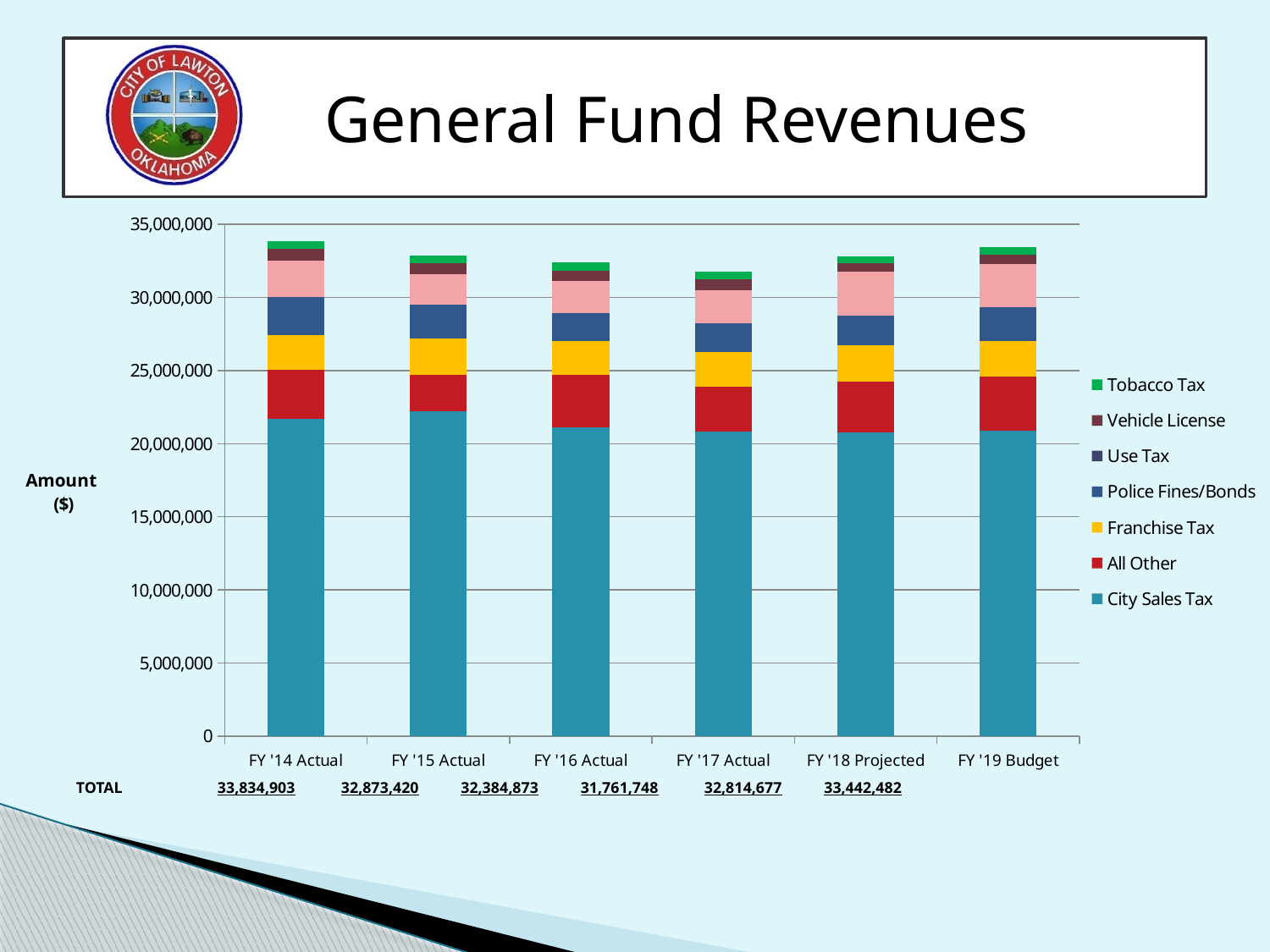
Is the City Sales Tax value for FY '15 Actual greater or less than 20,000,000? greater Which fiscal year has the lowest TOTAL general fund revenue? FY '17 Actual What is the TOTAL shown for FY '14 Actual? 33,834,903 What is the TOTAL shown for FY '19 Budget? 33,442,482 What is the TOTAL shown for FY '17 Actual? 31,761,748 Which TOTAL is larger, FY '15 Actual or FY '16 Actual? FY '15 Actual How many fiscal years are shown on the x axis? 6 What is the difference between the TOTAL for FY '14 Actual and the TOTAL for FY '17 Actual? 2,073,155 Which fiscal year has the highest TOTAL general fund revenue? FY '14 Actual How many revenue series does the legend list? 7 What kind of chart is shown on the slide? Stacked bar chart Which revenue series forms the bottom segment of each stacked bar? City Sales Tax